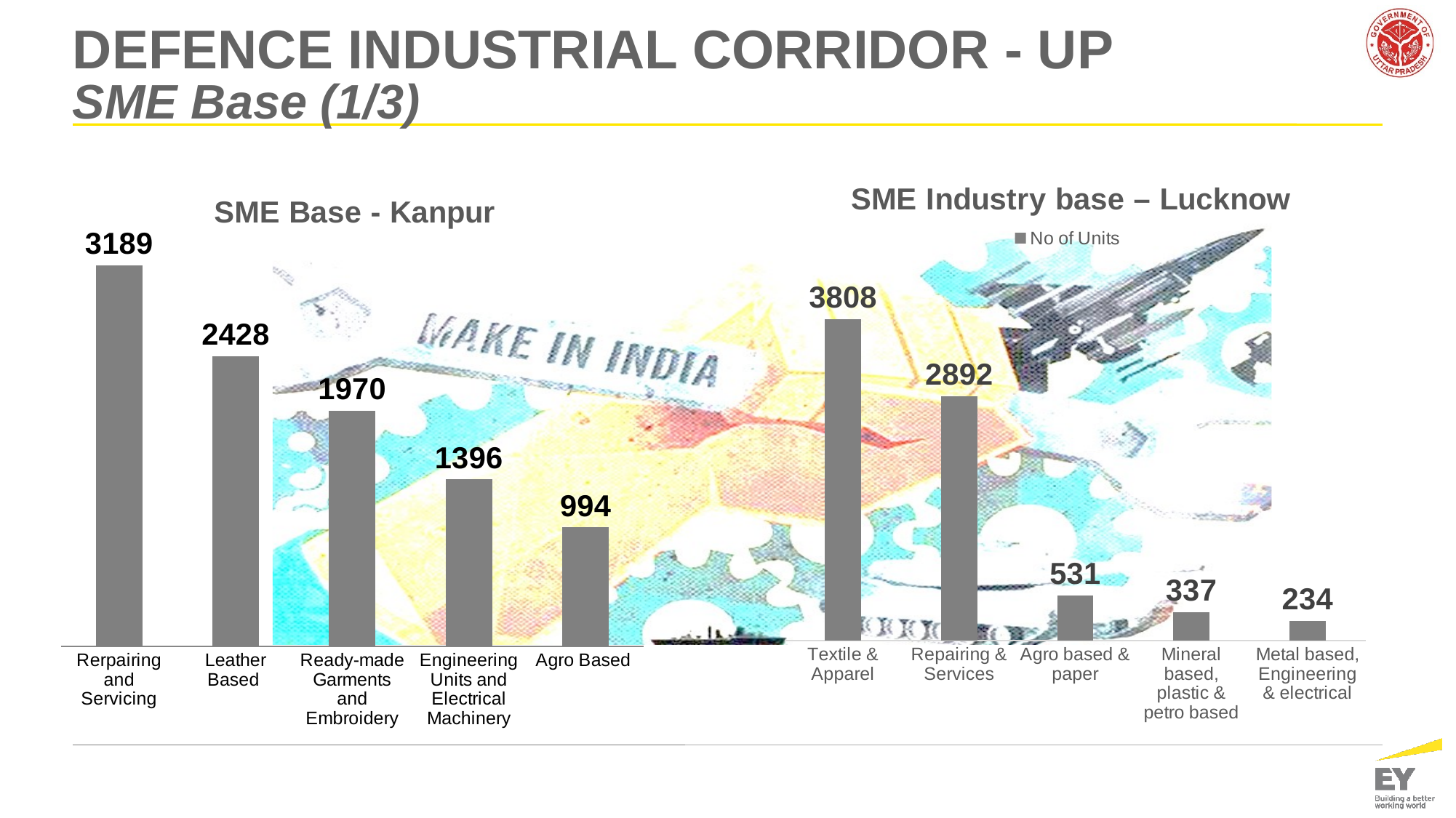
In the 'SME Base - Kanpur' chart, what is the difference between Ready-made Garments and Embroidery and Engineering Units and Electrical Machinery? 574 In the 'SME Industry base – Lucknow' chart, which category has the highest number of units? Textile & Apparel In the 'SME Industry base – Lucknow' chart, what is the value for Agro based & paper? 531 In the 'SME Base - Kanpur' chart, what is the value for Leather Based? 2428 What type of chart is the 'SME Industry base – Lucknow' chart? Bar chart What series name does the legend of the 'SME Industry base – Lucknow' chart show? No of Units In the 'SME Industry base – Lucknow' chart, which category has the lowest number of units? Metal based, Engineering & electrical In the 'SME Industry base – Lucknow' chart, which is larger: Mineral based, plastic & petro based or Metal based, Engineering & electrical? Mineral based, plastic & petro based In the 'SME Base - Kanpur' chart, which category has the highest value? Rerpairing and Servicing In the 'SME Industry base – Lucknow' chart, what is the difference between Textile & Apparel and Repairing & Services? 916 How many categories are shown in the 'SME Base - Kanpur' chart? 5 In the 'SME Base - Kanpur' chart, which category has the lowest value? Agro Based